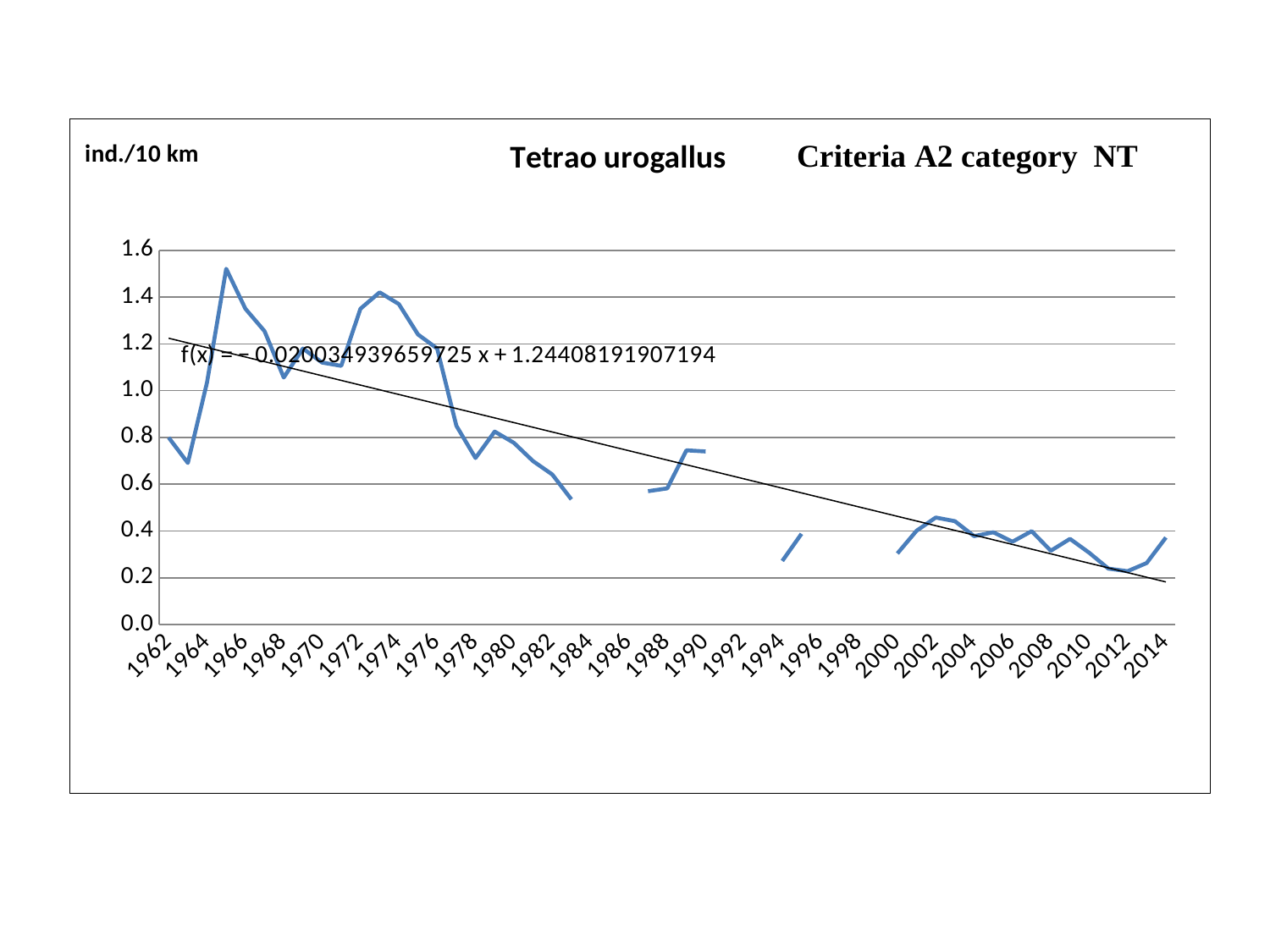
Is the value for 1966 greater or less than 1.4? less In which year does the line reach its highest value? 1965 Overall, do the values rise or fall from 1962 to 2014? fall Is the value for 1963 greater or less than 0.8? less Is the value for 1989 greater or less than 0.6? greater Which year has the larger value, 1962 or 2014? 1962 What is the species name given in the chart title? Tetrao urogallus What kind of chart is shown on the slide? line chart What unit label is shown at the top left of the chart? ind./10 km